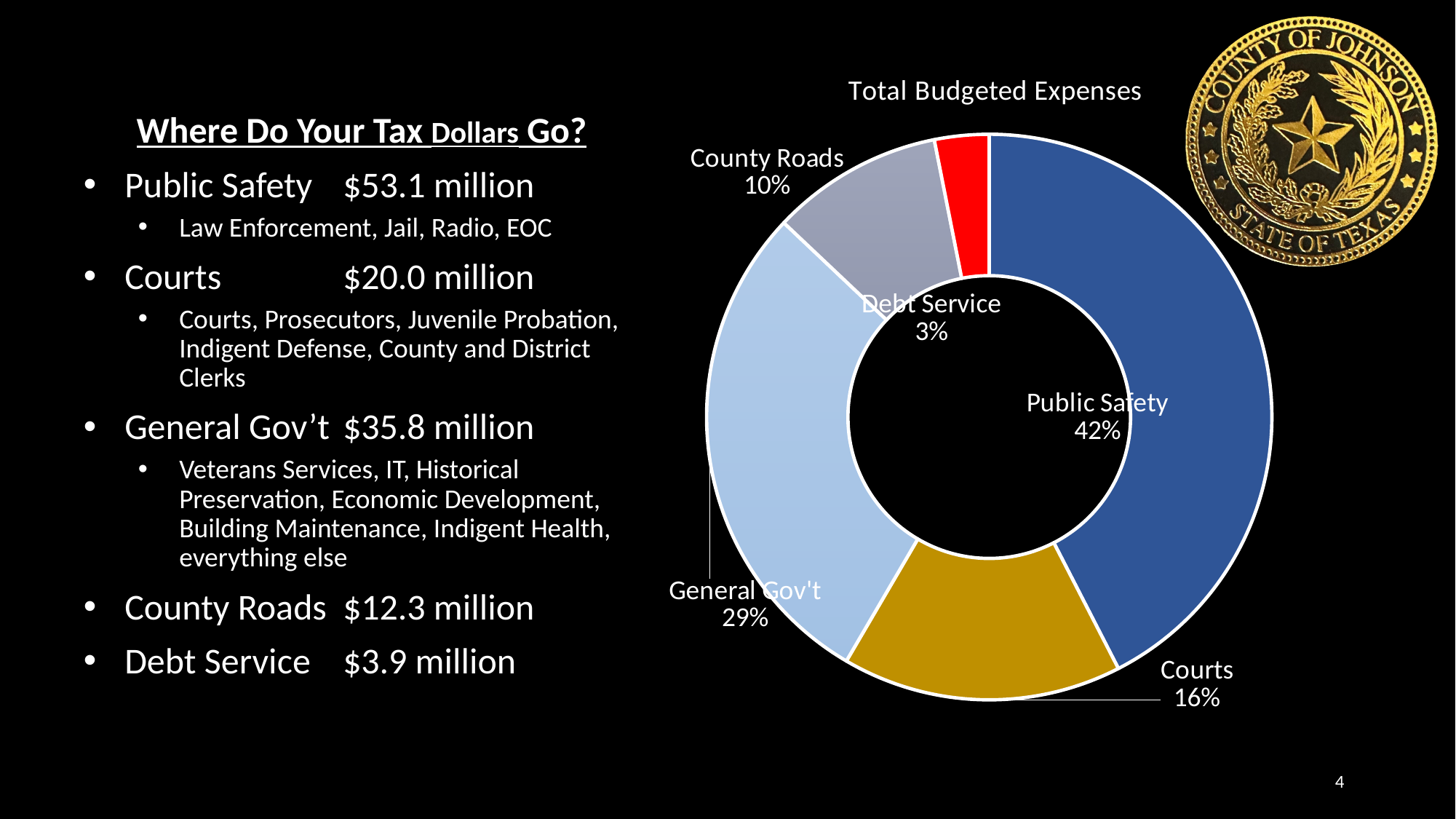
What share of Total Budgeted Expenses goes to Courts? 16% What is the title of the chart? Total Budgeted Expenses Which has a larger share, Courts or County Roads? Courts What is the difference in percentage points between the Public Safety and General Gov't shares? 13 What kind of chart is shown on the slide? Doughnut chart What share of Total Budgeted Expenses goes to County Roads? 10% Which category has the largest share of Total Budgeted Expenses? Public Safety What share of Total Budgeted Expenses goes to Public Safety? 42% Which category has the smallest share of Total Budgeted Expenses? Debt Service How many categories are shown in the chart? 5